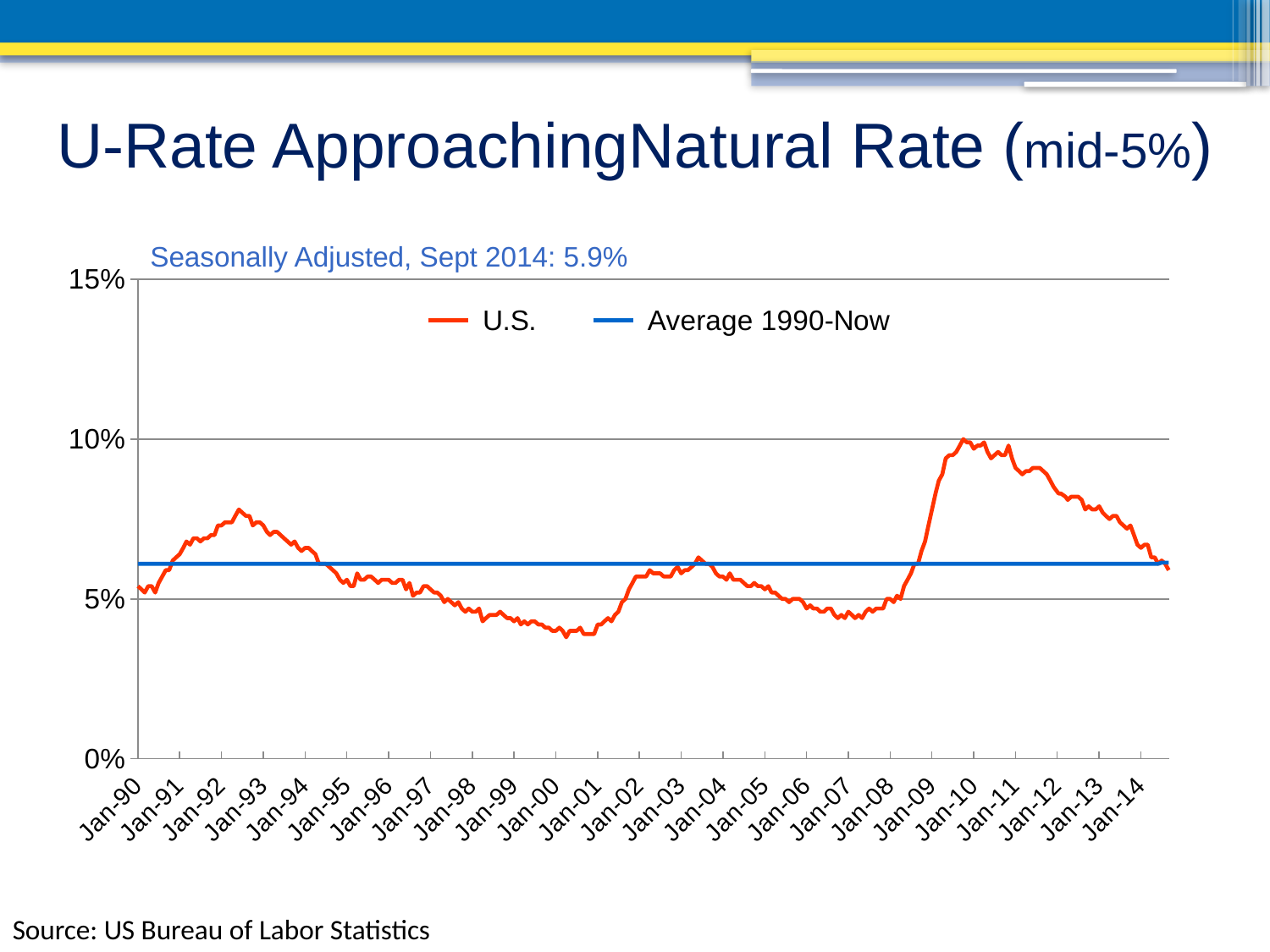
Is the U.S. value at Jan-00 greater or less than 5%? less According to the chart title, what was the seasonally adjusted U.S. unemployment rate in Sept 2014? 5.9% Does the U.S. line rise or fall between Jan-10 and Jan-14? fall Which is larger, the U.S. value at Jan-10 or at Jan-00? Jan-10 Is the U.S. value at Jan-07 greater or less than 5%? less How many labels are shown on the chart's x axis? 25 Is the U.S. value at Jan-10 greater or less than 5%? greater What kind of chart is shown on the slide? line chart What is the title of the chart? Seasonally Adjusted, Sept 2014: 5.9% How many series does the chart's legend list? 2 What are the two series named in the chart's legend? U.S. and Average 1990-Now Around which x-axis label does the U.S. line reach its highest point? Jan-10